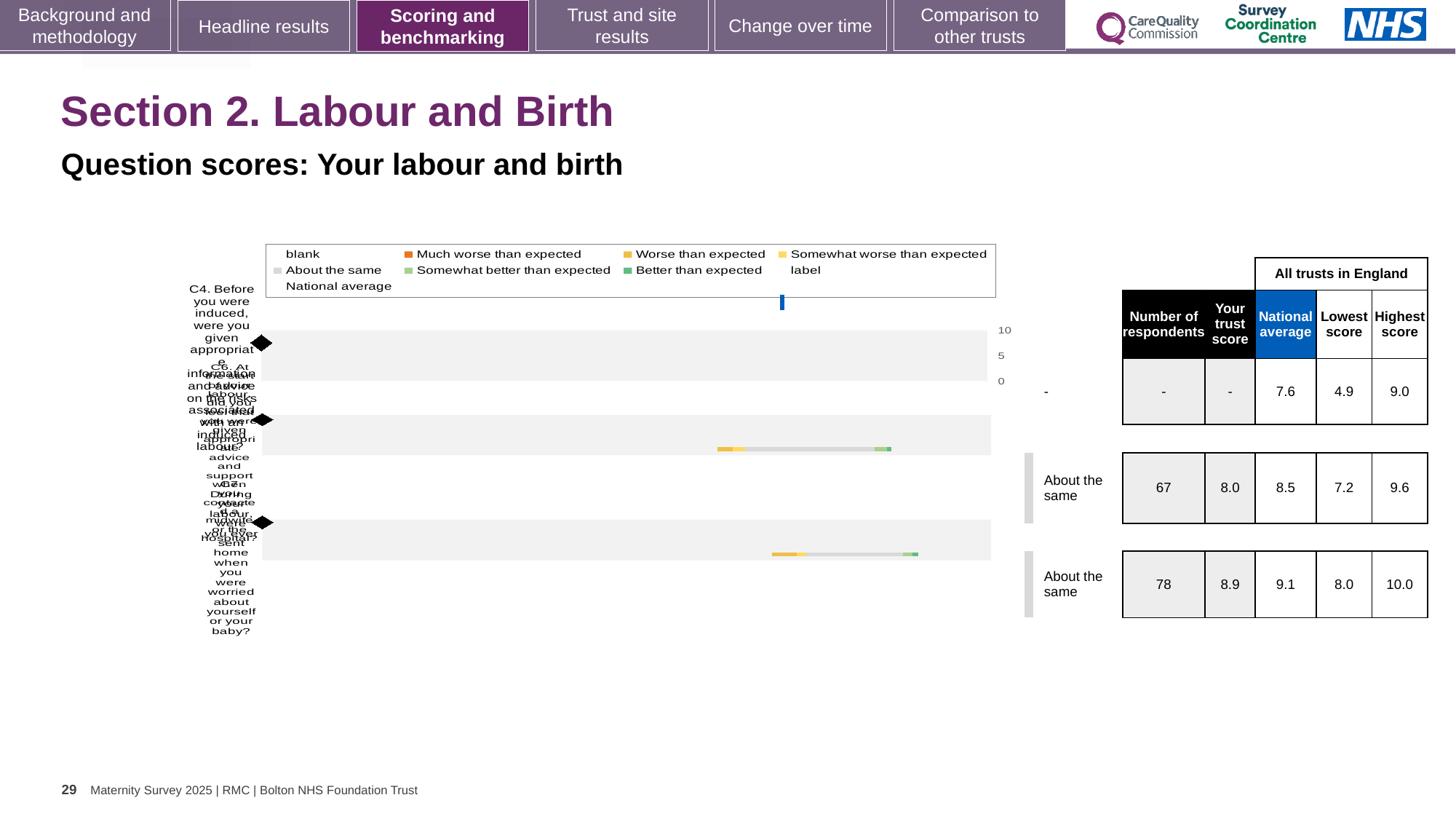
In the table, what is the national average for question C4? 7.6 How many entries does the chart legend list? 9 In the table, what is the highest score across all trusts in England for question C7? 10.0 How many question categories (C4, C6, C7) are plotted on the chart? 3 In the table, what is the number of respondents for question C6? 67 In the table, which question has the lowest 'Lowest score' value? C4 In the table, what is the trust score for question C7? 8.9 What kind of chart is shown on the slide? bar chart What is the highest value shown on the chart's numeric axis? 10 Which legend entry is shown in orange? Much worse than expected In the table, what is the difference between the national average and the trust score for question C6? 0.5 In the table, is the trust score for C7 larger or smaller than the trust score for C6? larger